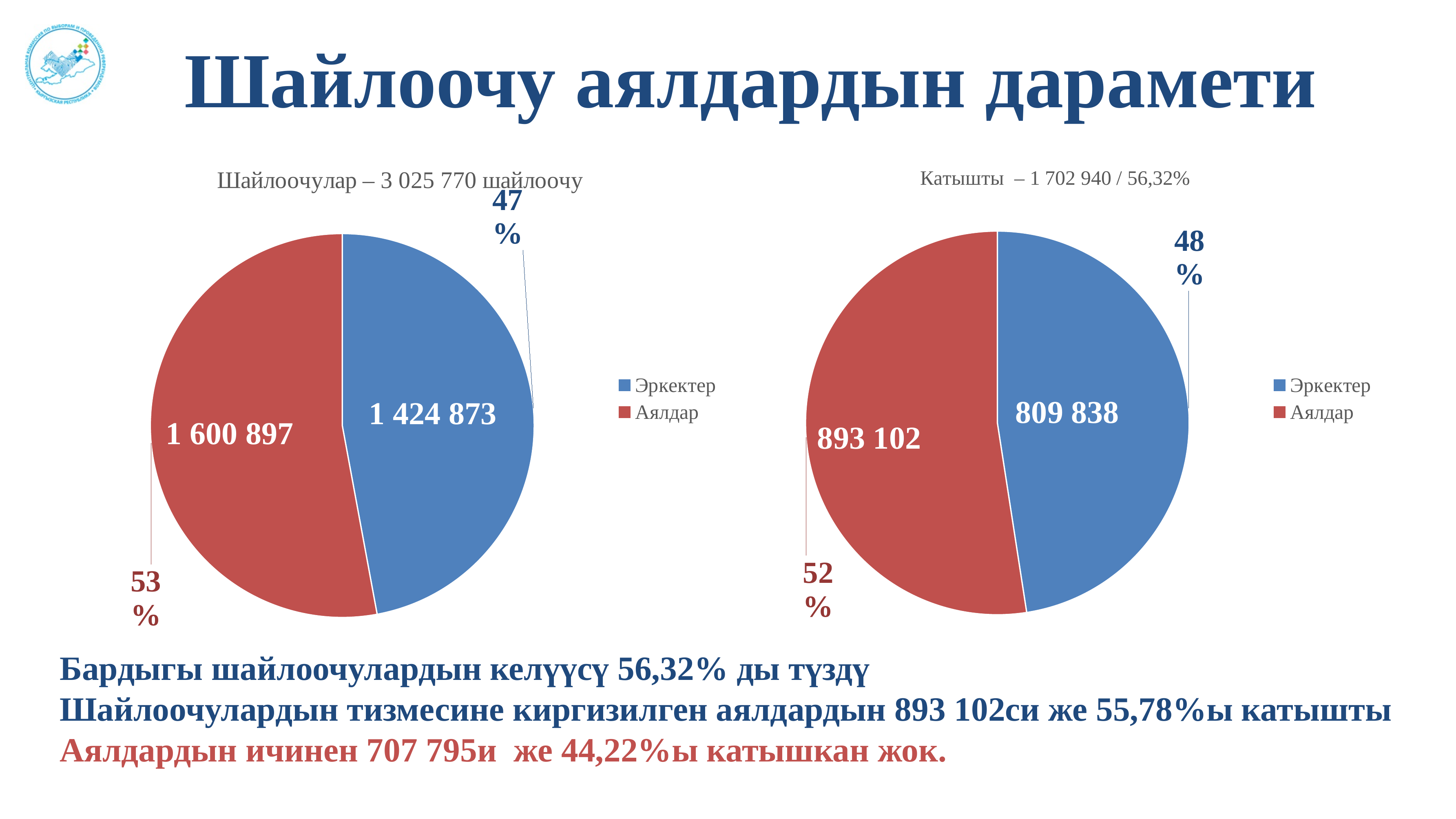
How many series does the legend of the left chart (Шайлоочулар – 3 025 770 шайлоочу) list? 2 In the left chart (Шайлоочулар – 3 025 770 шайлоочу), what is the value for Эркектер? 1 424 873 In the right chart (Катышты – 1 702 940 / 56,32%), what is the value for Аялдар? 893 102 In the right chart (Катышты – 1 702 940 / 56,32%), which category has the smallest slice? Эркектер In the left chart (Шайлоочулар – 3 025 770 шайлоочу), what is the difference between the values for Аялдар and Эркектер? 176 024 In the left chart (Шайлоочулар – 3 025 770 шайлоочу), what share of the pie does Аялдар take? 53% In the right chart (Катышты – 1 702 940 / 56,32%), what is the difference between the values for Аялдар and Эркектер? 83 264 What type of chart is the right chart (Катышты – 1 702 940 / 56,32%)? Pie chart In the right chart (Катышты – 1 702 940 / 56,32%), what is the value for Эркектер? 809 838 In the left chart (Шайлоочулар – 3 025 770 шайлоочу), what is the value for Аялдар? 1 600 897 In the right chart (Катышты – 1 702 940 / 56,32%), what share of the pie does Эркектер take? 48% In the left chart (Шайлоочулар – 3 025 770 шайлоочу), which category has the largest slice? Аялдар